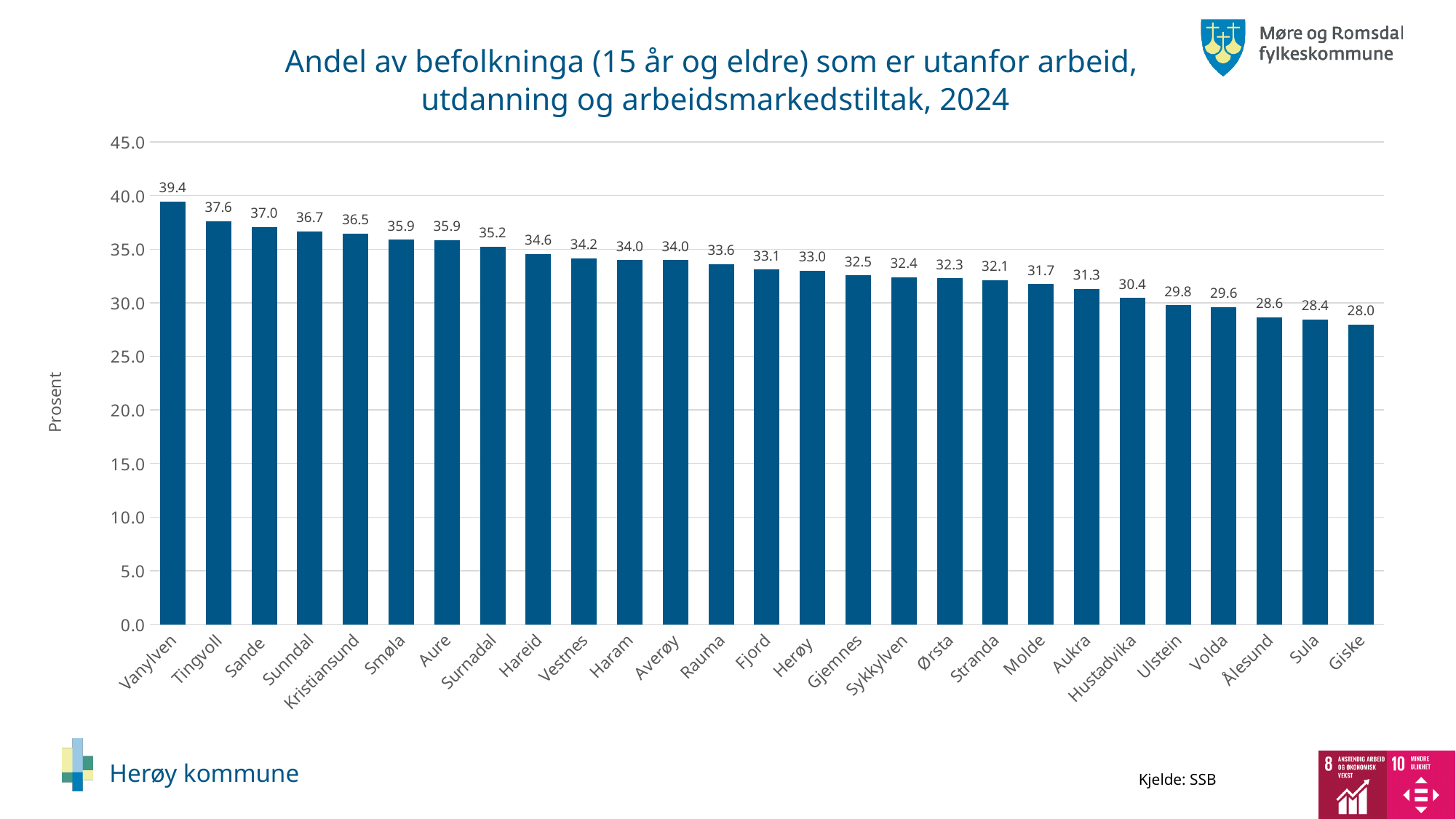
What is the difference between the values for Tingvoll and Ålesund? 9.0 Which has a larger value, Sande or Volda? Sande How many municipalities are shown on the chart? 27 Is the value for Ulstein greater or less than 30.0? less What is the label on the vertical axis? Prosent What kind of chart is this? bar chart Which municipality has the highest value? Vanylven Which municipality has the lowest value? Giske What is the value for Molde? 31.7 What is the value for Kristiansund? 36.5 What is the value for Herøy? 33.0 What is the difference between the values for Vanylven and Giske? 11.4